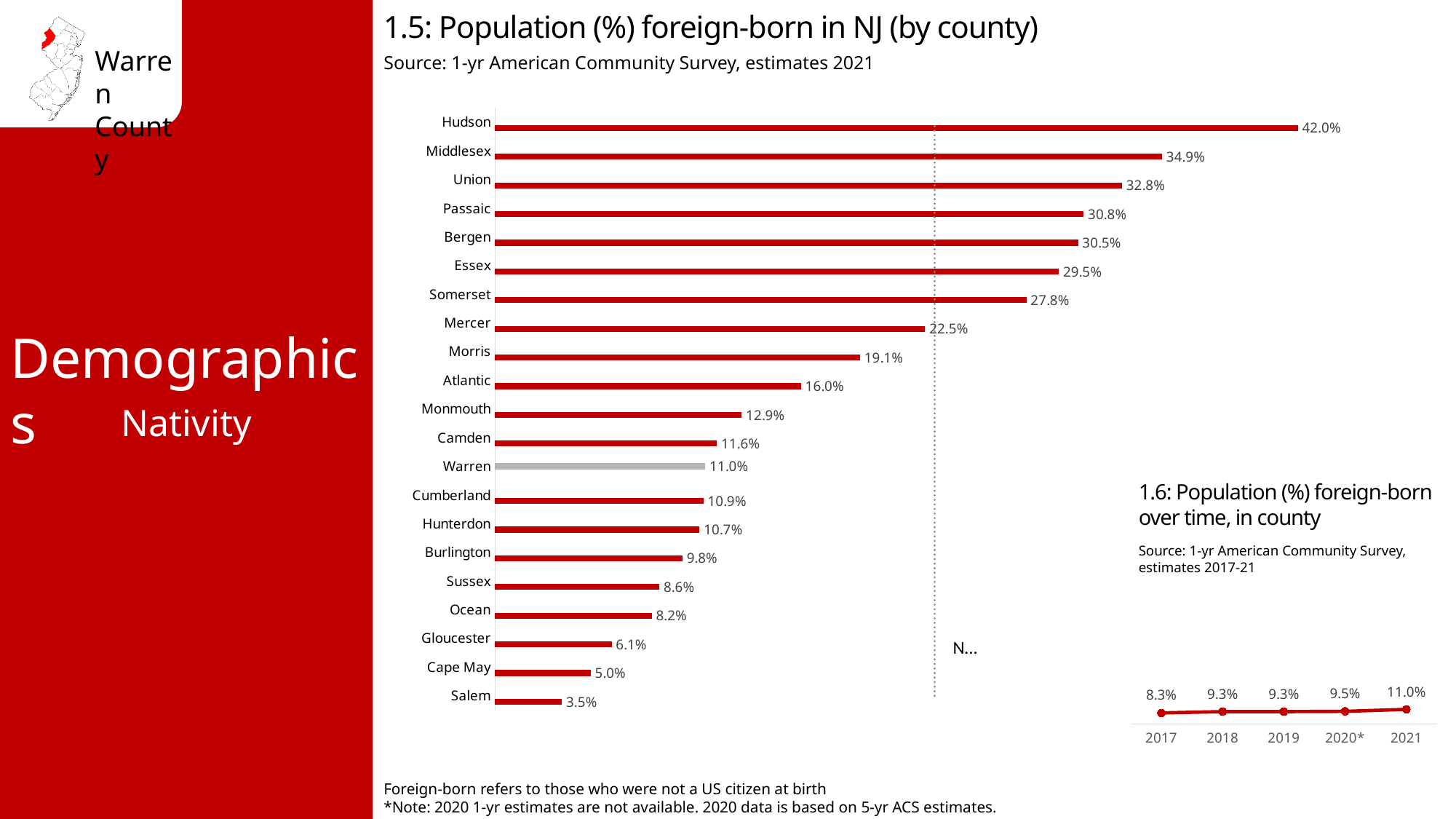
In chart 1.6 (Population (%) foreign-born over time, in county), what is the difference between 2021 and 2020*? 1.5% In chart 1.6 (Population (%) foreign-born over time, in county), what is the value for 2017? 8.3% In chart 1.5 (Population (%) foreign-born in NJ by county), what is the value for Warren? 11.0% In chart 1.5 (Population (%) foreign-born in NJ by county), which is larger, Passaic or Bergen? Passaic In chart 1.5 (Population (%) foreign-born in NJ by county), how many counties are shown? 21 In chart 1.5 (Population (%) foreign-born in NJ by county), what is the value for Middlesex? 34.9% What kind of chart is chart 1.5 (Population (%) foreign-born in NJ by county)? Bar chart In chart 1.5 (Population (%) foreign-born in NJ by county), which county has the highest value? Hudson In chart 1.6 (Population (%) foreign-born over time, in county), do the values rise or fall from 2017 to 2021? Rise In chart 1.5 (Population (%) foreign-born in NJ by county), what is the difference between Hudson and Salem? 38.5% In chart 1.5 (Population (%) foreign-born in NJ by county), which county's bar is coloured grey instead of red? Warren In chart 1.5 (Population (%) foreign-born in NJ by county), which county has the lowest value? Salem